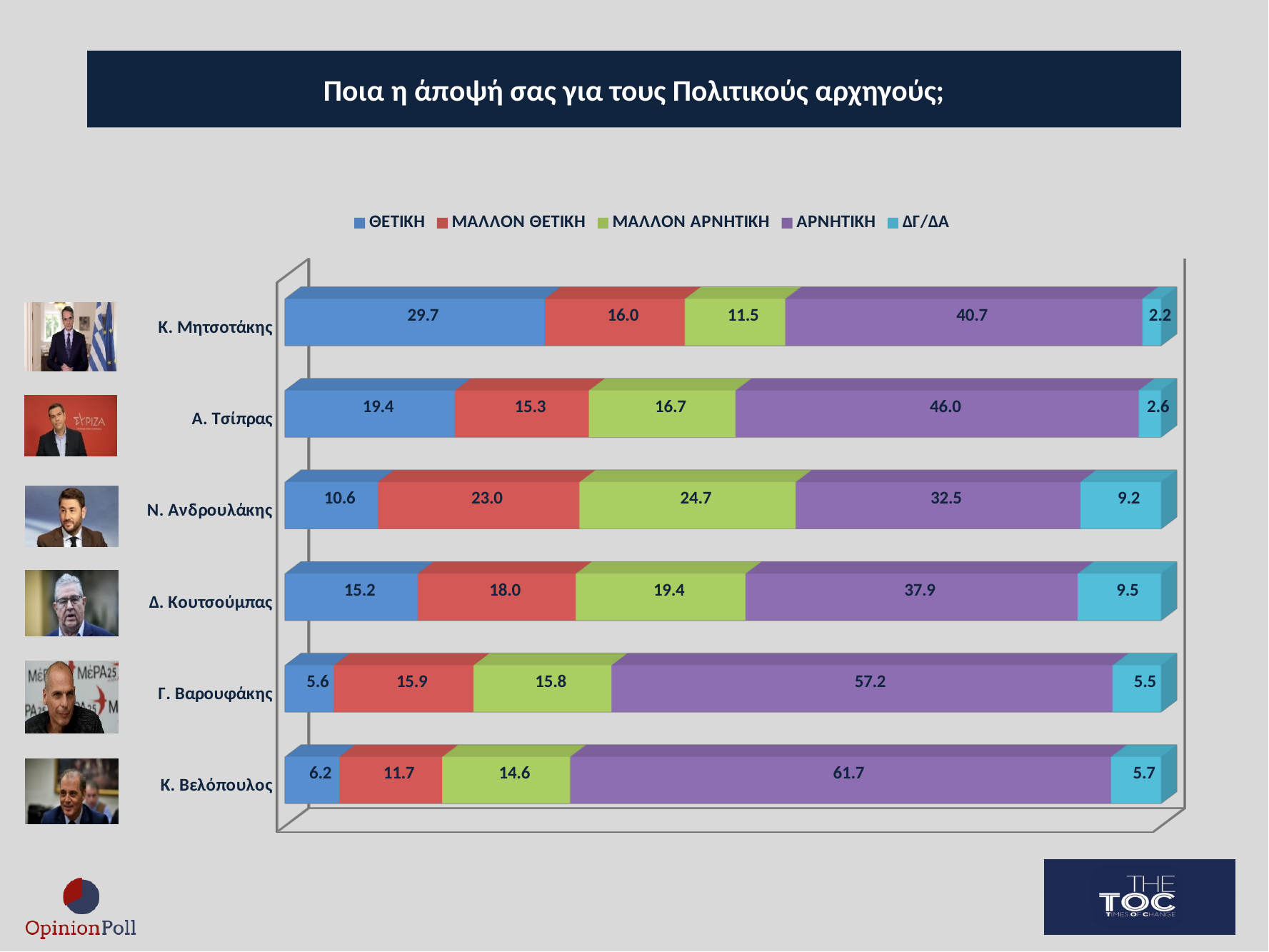
Which politician has the highest ΑΡΝΗΤΙΚΗ value? Κ. Βελόπουλος What is the total of the stacked bar for Α. Τσίπρας? 100.0 What is the ΔΓ/ΔΑ value for Δ. Κουτσούμπας? 9.5 How many politicians are shown in the chart? 6 How many series does the legend list? 5 What is the ΑΡΝΗΤΙΚΗ value for Κ. Βελόπουλος? 61.7 Which colour represents the ΑΡΝΗΤΙΚΗ series in the chart? Purple What is the difference between the ΘΕΤΙΚΗ values of Κ. Μητσοτάκης and Α. Τσίπρας? 10.3 What kind of chart is shown on the slide? Stacked bar chart Which is larger: the ΜΑΛΛΟΝ ΑΡΝΗΤΙΚΗ value for Ν. Ανδρουλάκης or for Δ. Κουτσούμπας? Ν. Ανδρουλάκης What is the ΘΕΤΙΚΗ value for Κ. Μητσοτάκης? 29.7 Which politician has the lowest ΘΕΤΙΚΗ value? Γ. Βαρουφάκης